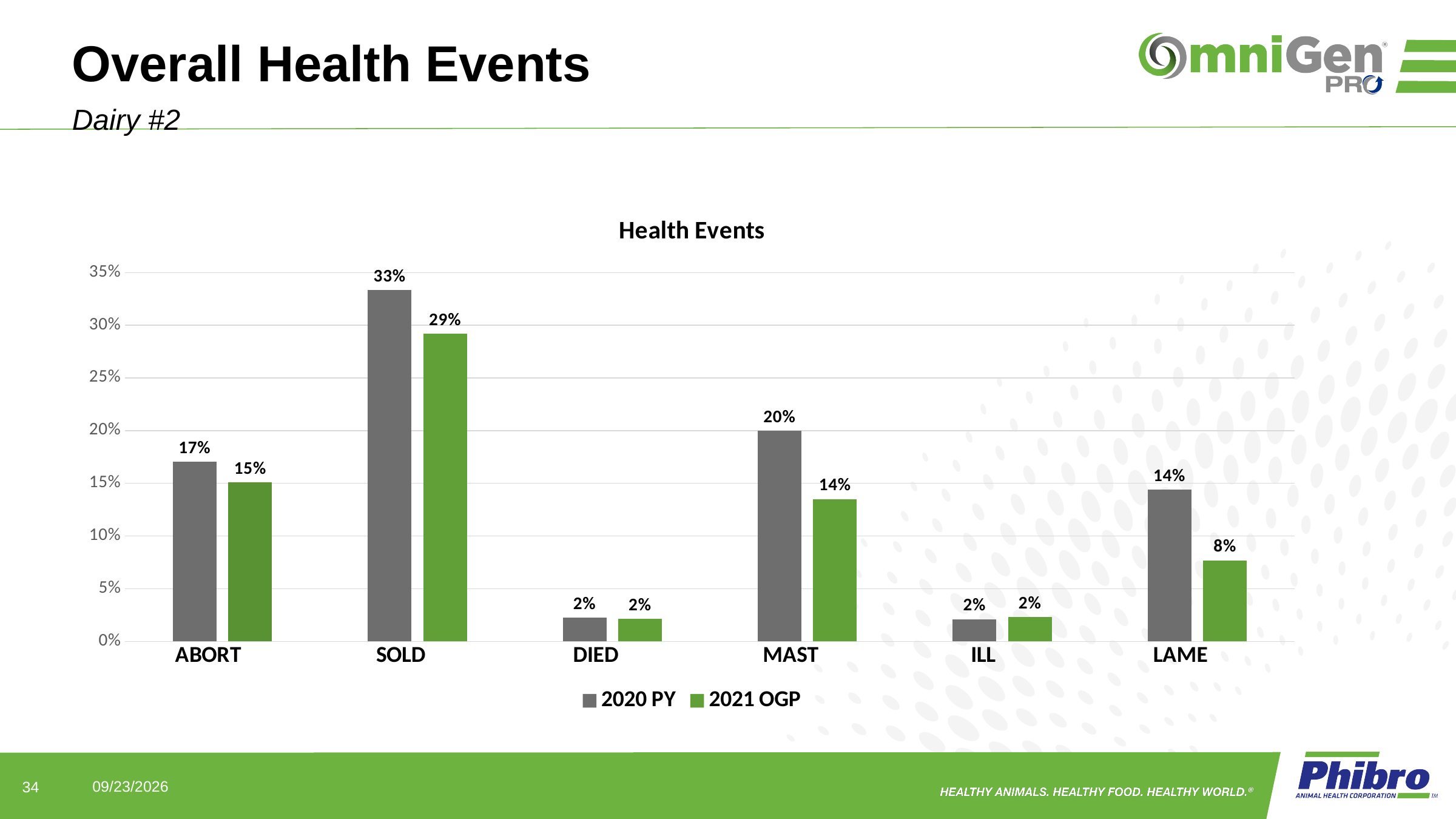
What is the 2021 OGP value for MAST? 14% Which category has the lowest 2021 OGP value? DIED and ILL (both 2%) How many categories are shown on the x axis? 6 How many series does the legend list? 2 What is the 2021 OGP value for LAME? 8% What is the difference between the 2020 PY and 2021 OGP values for LAME? 6% What is the 2020 PY value for SOLD? 33% What is the title of the chart? Health Events What is the difference between the 2020 PY and 2021 OGP values for MAST? 6% Which is larger for ABORT: the 2020 PY value or the 2021 OGP value? 2020 PY Which category has the highest 2020 PY value? SOLD What kind of chart is shown on the slide? Bar chart